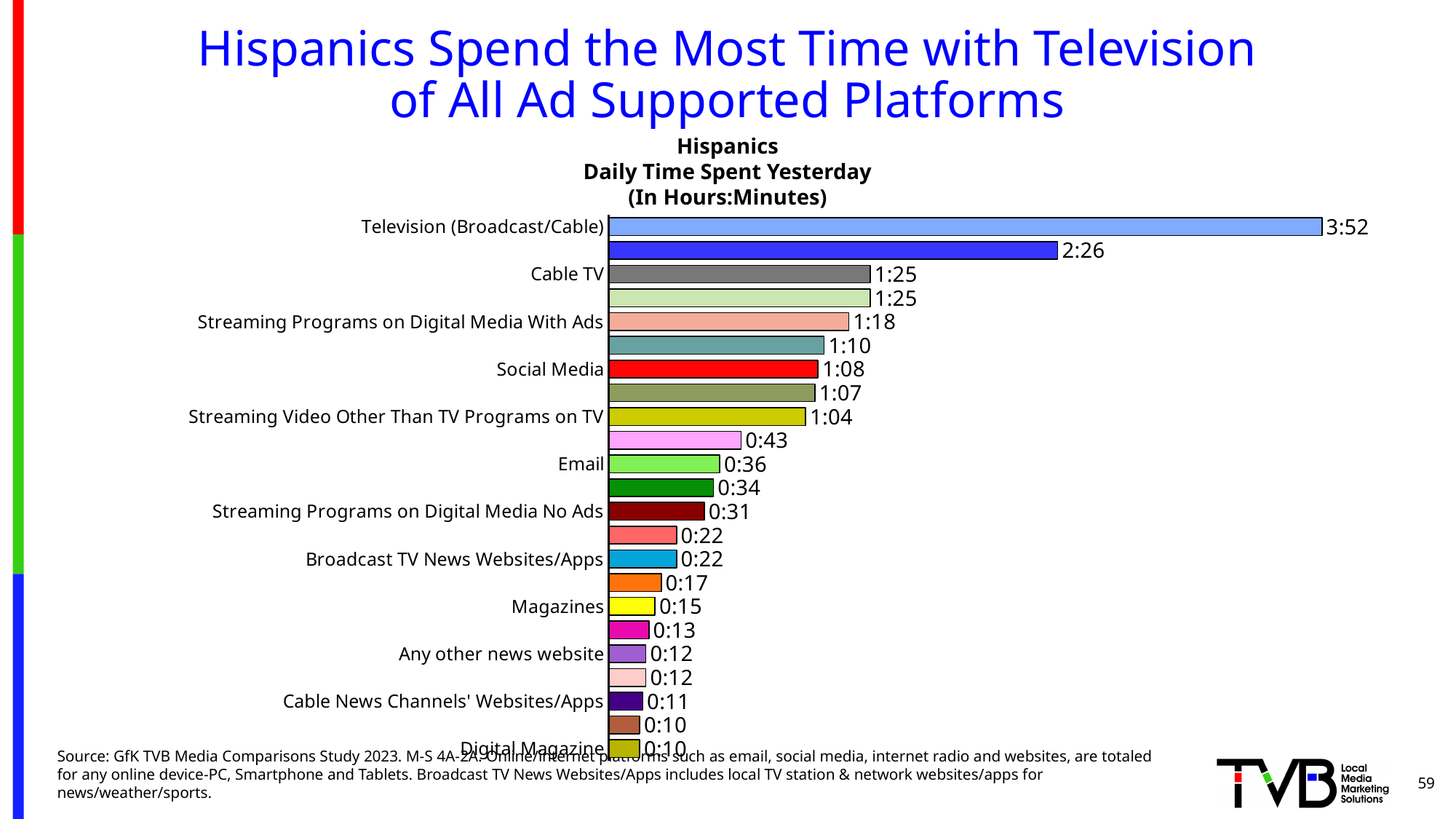
Which has a higher daily time spent, Cable TV or Social Media? Cable TV How much more time is spent with Television (Broadcast/Cable) than with Cable TV? 2:27 What is the daily time spent with Social Media? 1:08 What is the daily time spent with Cable TV? 1:25 What is the daily time spent with Email? 0:36 What is the daily time spent with Magazines? 0:15 What is the daily time spent with Television (Broadcast/Cable)? 3:52 Which platform has the highest daily time spent? Television (Broadcast/Cable) How many bars are plotted in the chart? 23 What is the daily time spent with Streaming Programs on Digital Media No Ads? 0:31 What type of chart is shown on the slide? Bar chart How much more time is spent with Social Media than with Email? 0:32